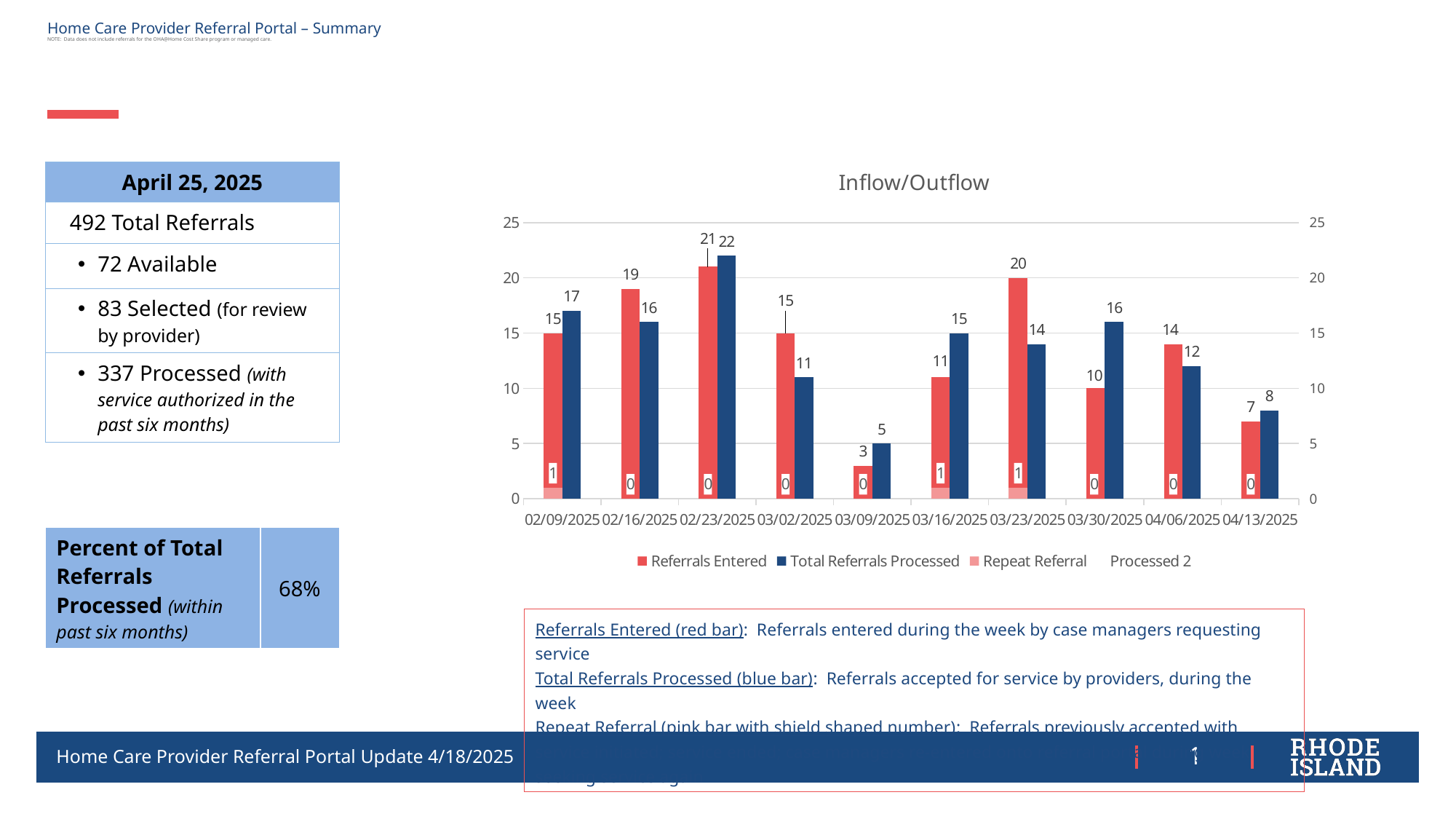
In the Inflow/Outflow chart, what is the difference between Referrals Entered and Total Referrals Processed for 03/23/2025? 6 In the Inflow/Outflow chart, what is the value of Total Referrals Processed for 03/30/2025? 16 In the Inflow/Outflow chart, which is larger for 03/02/2025: Referrals Entered or Total Referrals Processed? Referrals Entered How many weeks (dates) are shown on the x axis of the Inflow/Outflow chart? 10 In the Inflow/Outflow chart, what is the value of Referrals Entered for 02/23/2025? 21 In the Inflow/Outflow chart, which week has the lowest Referrals Entered value? 03/09/2025 In the Inflow/Outflow chart, which week has the highest Total Referrals Processed value? 02/23/2025 In the Inflow/Outflow chart, is the Referrals Entered value for 02/16/2025 greater or less than 15? greater In the Inflow/Outflow chart, what is the Repeat Referral value for 03/16/2025? 1 What kind of chart is the Inflow/Outflow chart? Bar chart How many series does the legend of the Inflow/Outflow chart list? 4 What is the title of the chart on the slide? Inflow/Outflow